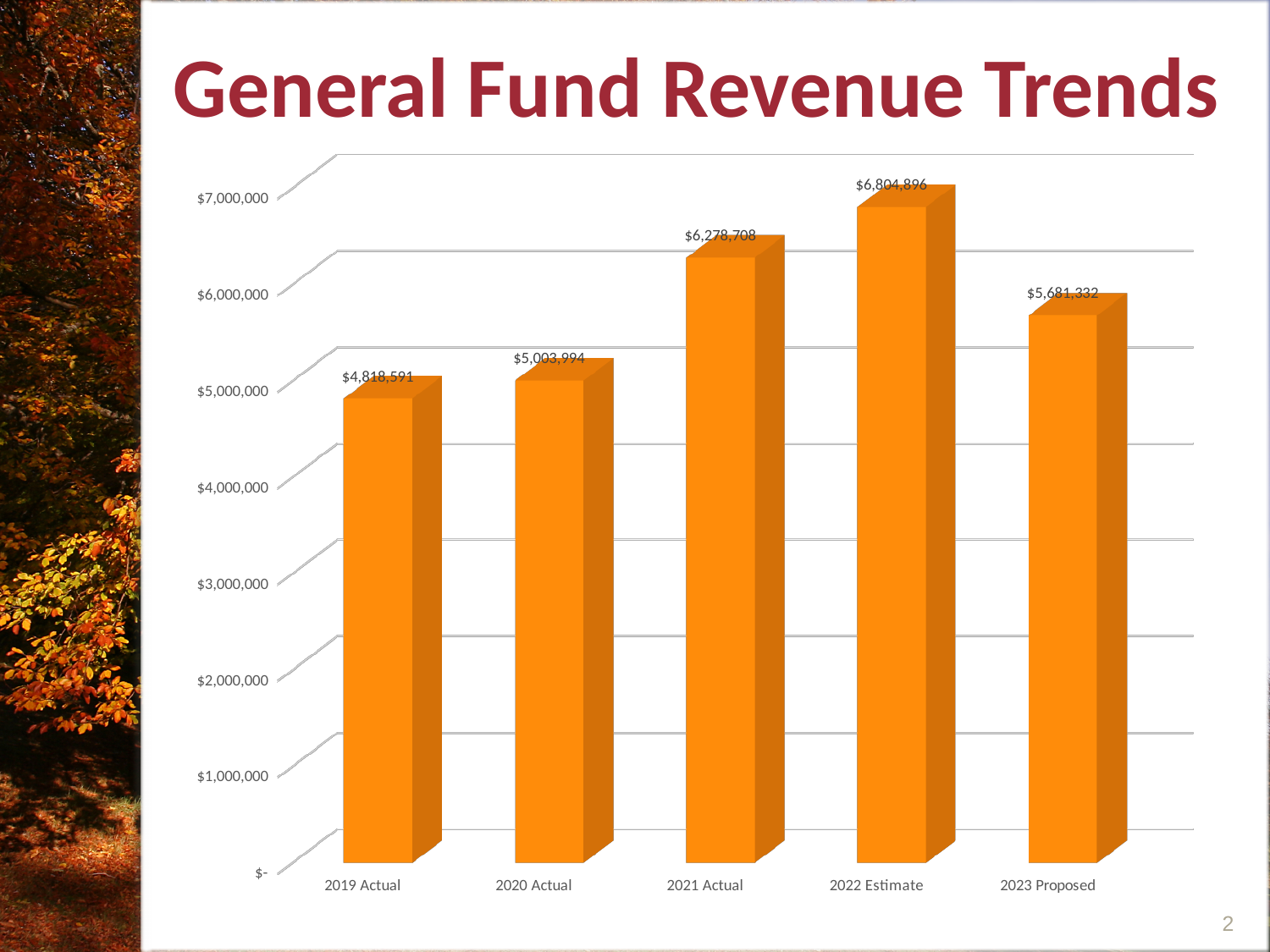
What is the value for 2022 Estimate? $6,804,896 What is the difference between the 2022 Estimate and 2021 Actual values? $526,188 What is the value for 2021 Actual? $6,278,708 What is the difference between the 2020 Actual and 2019 Actual values? $185,403 Is the value for 2020 Actual greater or less than $6,000,000? less Which category has the lowest value? 2019 Actual What is the value for 2023 Proposed? $5,681,332 Which is larger, the value for 2023 Proposed or the value for 2021 Actual? 2021 Actual What kind of chart is shown on the slide? bar chart Which category has the highest value? 2022 Estimate What is the value for 2019 Actual? $4,818,591 How many categories are shown on the x axis? 5